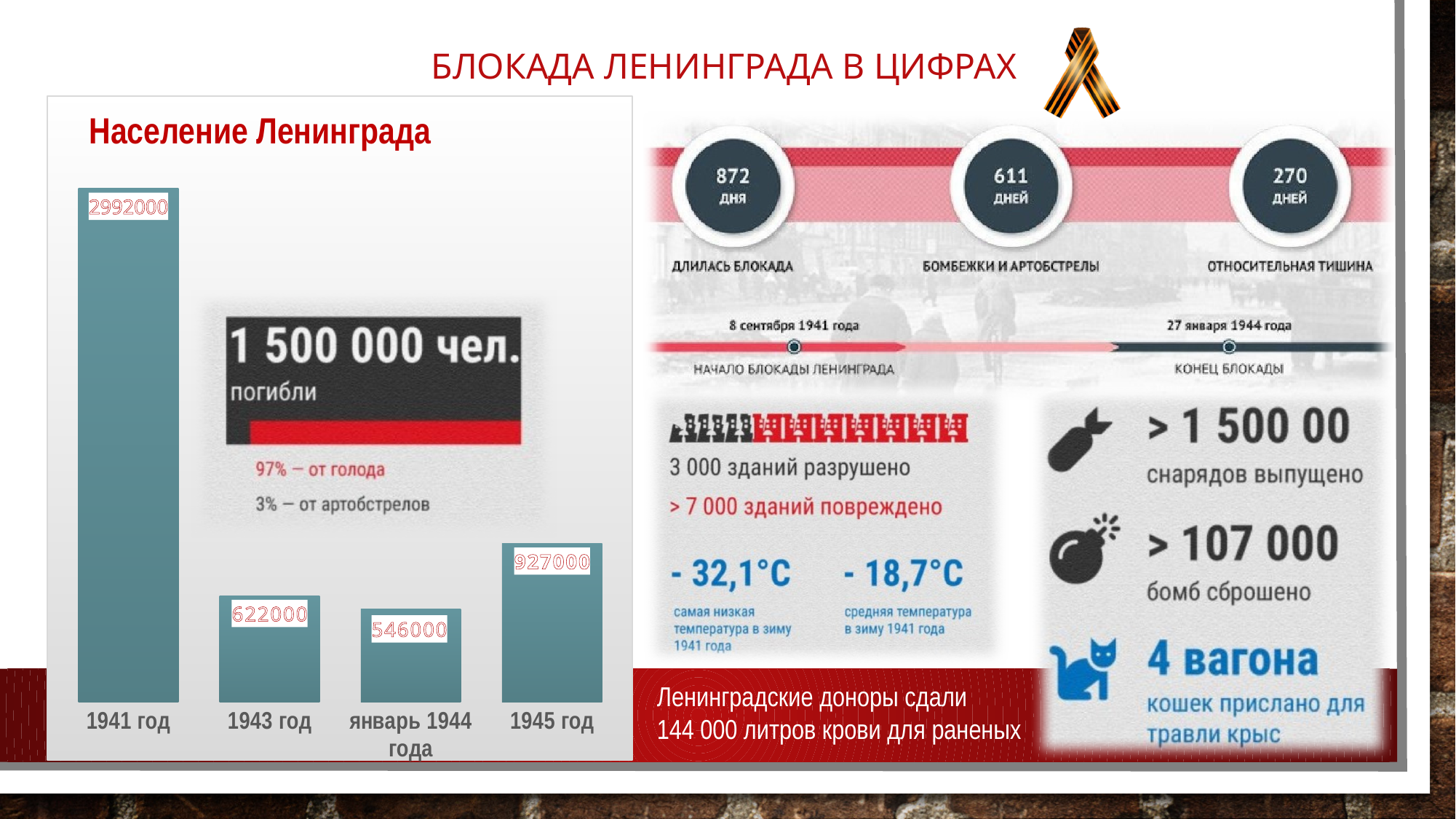
How many categories are shown in the Население Ленинграда chart? 4 What is the value for январь 1944 года in the Население Ленинграда chart? 546000 What is the value for 1941 год in the Население Ленинграда chart? 2992000 Which is larger in the Население Ленинграда chart: the value for 1943 год or the value for 1945 год? 1945 год What is the difference between the values for 1943 год and январь 1944 года in the Население Ленинграда chart? 76000 Which category has the highest value in the Население Ленинграда chart? 1941 год What kind of chart is the Население Ленинграда chart? bar chart What is the value for 1945 год in the Население Ленинграда chart? 927000 What is the difference between the values for 1941 год and 1945 год in the Население Ленинграда chart? 2065000 What is the title of the chart on the left side of the slide? Население Ленинграда What is the value for 1943 год in the Население Ленинграда chart? 622000 Which category has the lowest value in the Население Ленинграда chart? январь 1944 года